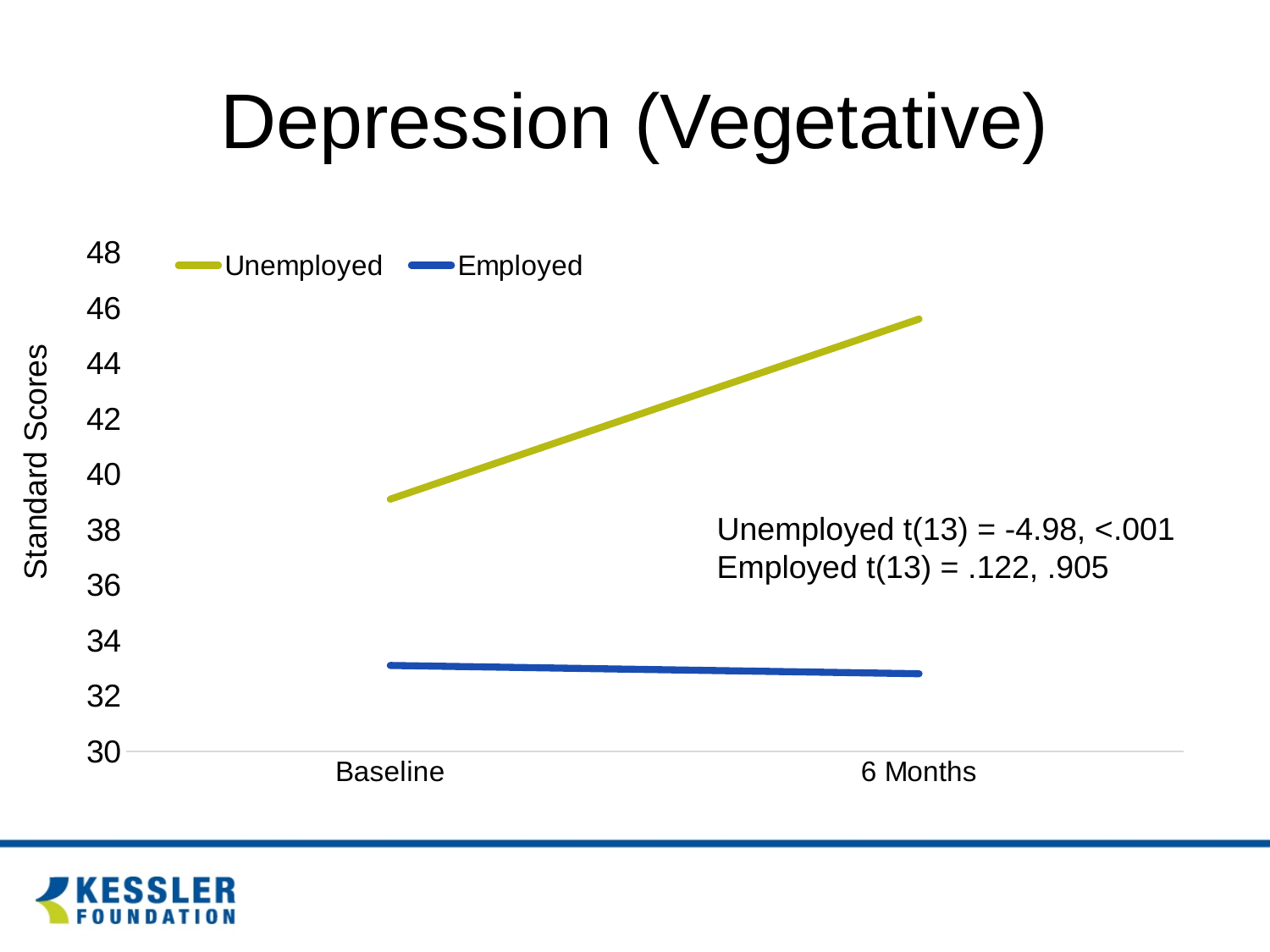
Does the Employed line rise or fall from Baseline to 6 Months? fall How many time points are shown on the x axis? 2 Is the Unemployed value at Baseline greater or less than 40? less Does the Unemployed line rise or fall from Baseline to 6 Months? rise Is the Unemployed value at 6 Months greater or less than 44? greater Is the Employed value at Baseline greater or less than 34? less How many series does the legend list? 2 Which series has the higher value at Baseline, Unemployed or Employed? Unemployed What kind of chart is shown on the slide? line chart What is the label on the y axis? Standard Scores Which series has the higher value at 6 Months, Unemployed or Employed? Unemployed What is the title of the chart? Depression (Vegetative)